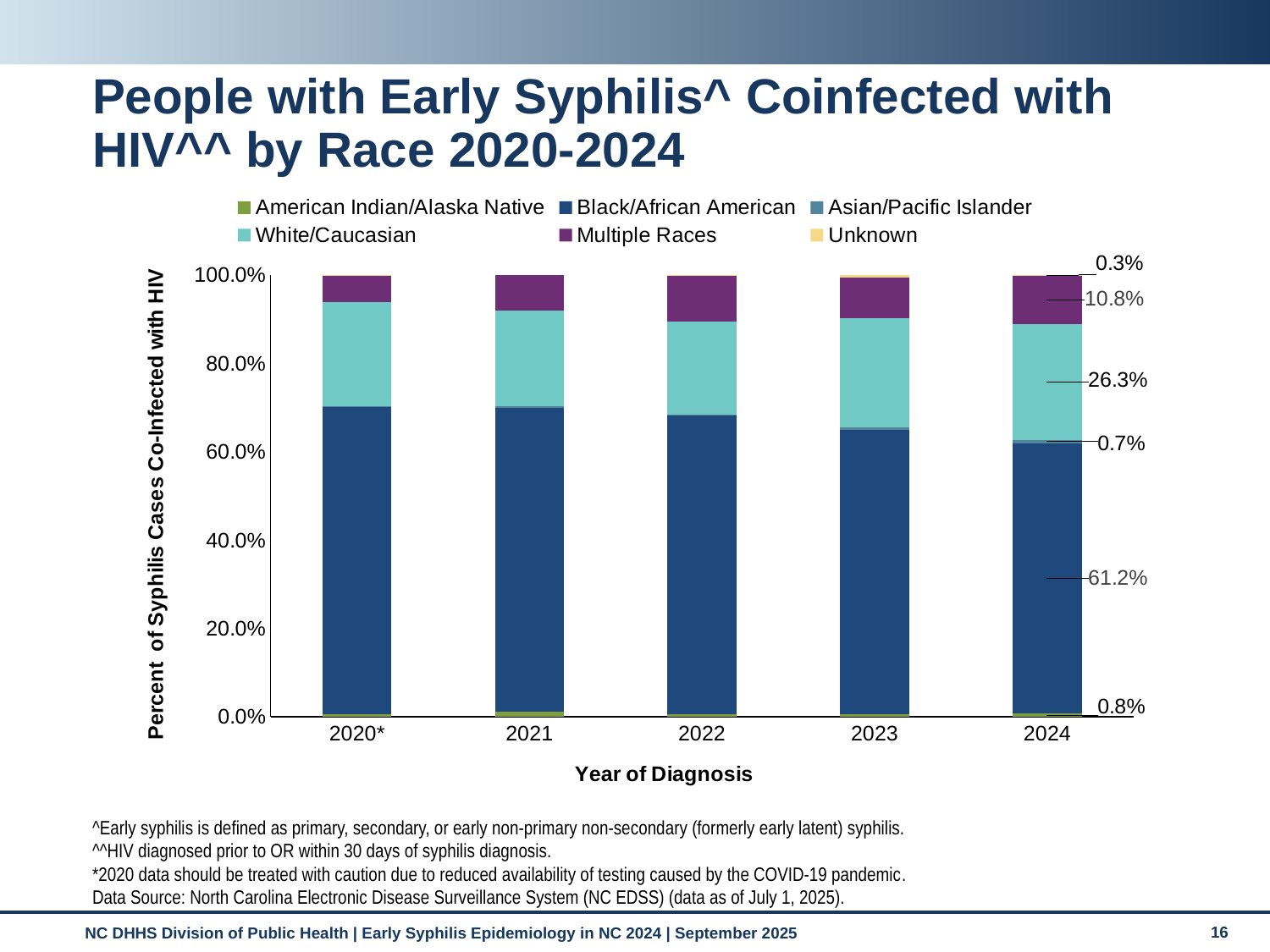
Is the Black/African American share in 2020* greater or less than 60.0%? greater In 2024, which is larger: the White/Caucasian share or the Multiple Races share? White/Caucasian What is the Unknown race share labeled for 2024? 0.3% What is the Asian/Pacific Islander value labeled for 2024? 0.7% What is the American Indian/Alaska Native value labeled for 2024? 0.8% What is the White/Caucasian share shown for 2024? 26.3% What is the Multiple Races value labeled for 2024? 10.8% How many race categories does the legend list? 6 Which race group has the largest share in the 2024 bar? Black/African American In 2024, what is the difference between the Black/African American share and the White/Caucasian share? 34.9 percentage points What percentage of people with early syphilis coinfected with HIV in 2024 were Black/African American? 61.2% How many years of diagnosis are shown on the x axis? 5